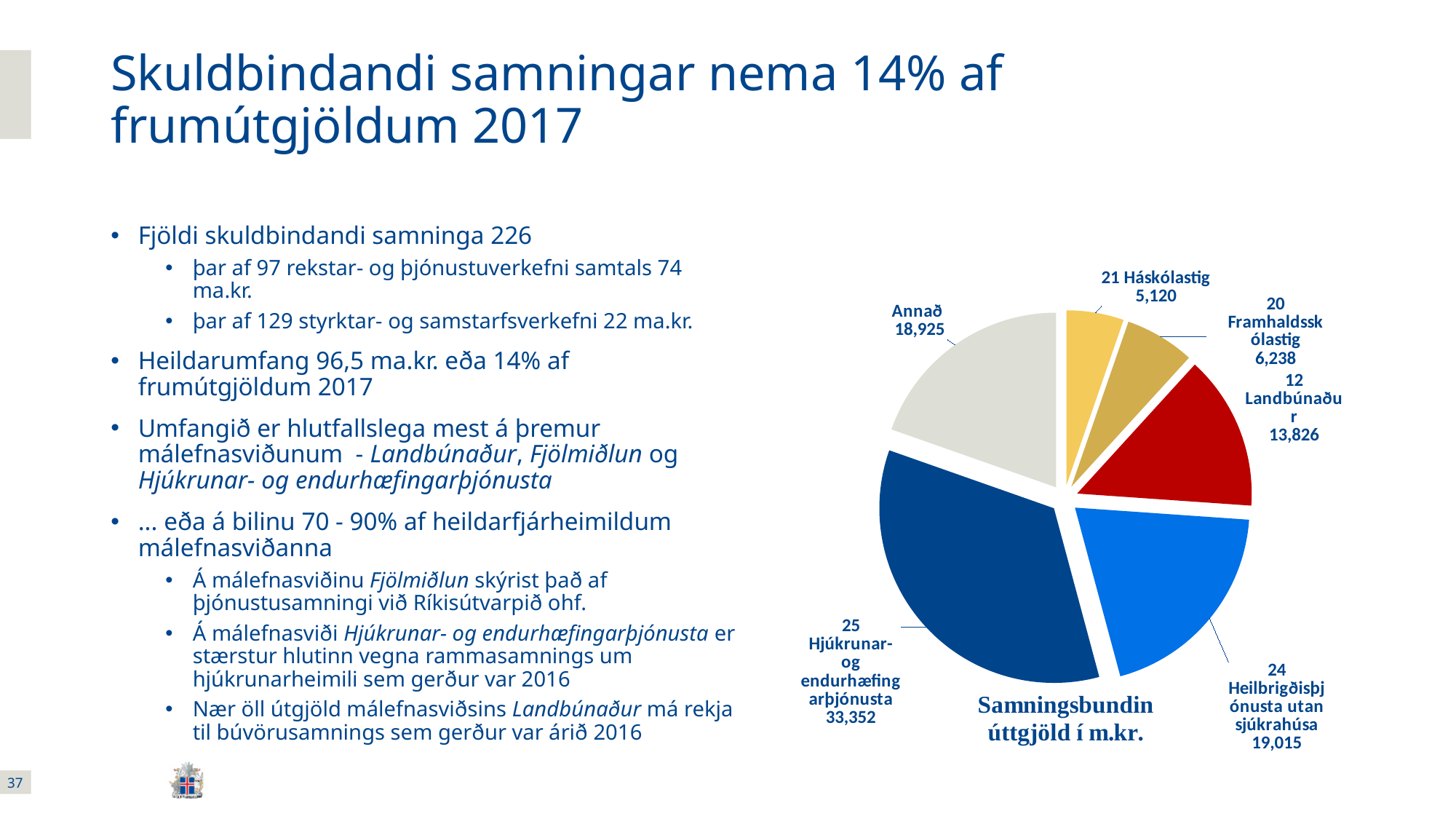
What is the value for 21 Háskólastig in the pie chart? 5,120 Which slice of the pie chart is the smallest? 21 Háskólastig Which is larger in the pie chart: 12 Landbúnaður or 20 Framhaldsskólastig? 12 Landbúnaður How many slices does the pie chart have? 6 What is the difference between the values for 25 Hjúkrunar- og endurhæfingarþjónusta and 24 Heilbrigðisþjónusta utan sjúkrahúsa? 14,337 What type of chart is shown on the slide? pie chart What is the title of the pie chart? Samningsbundin úttgjöld í m.kr. Which slice of the pie chart is the largest? 25 Hjúkrunar- og endurhæfingarþjónusta What colour is the slice for 12 Landbúnaður in the pie chart? red What is the value for 12 Landbúnaður in the pie chart? 13,826 What is the value for 25 Hjúkrunar- og endurhæfingarþjónusta in the pie chart? 33,352 What is the value for Annað in the pie chart? 18,925